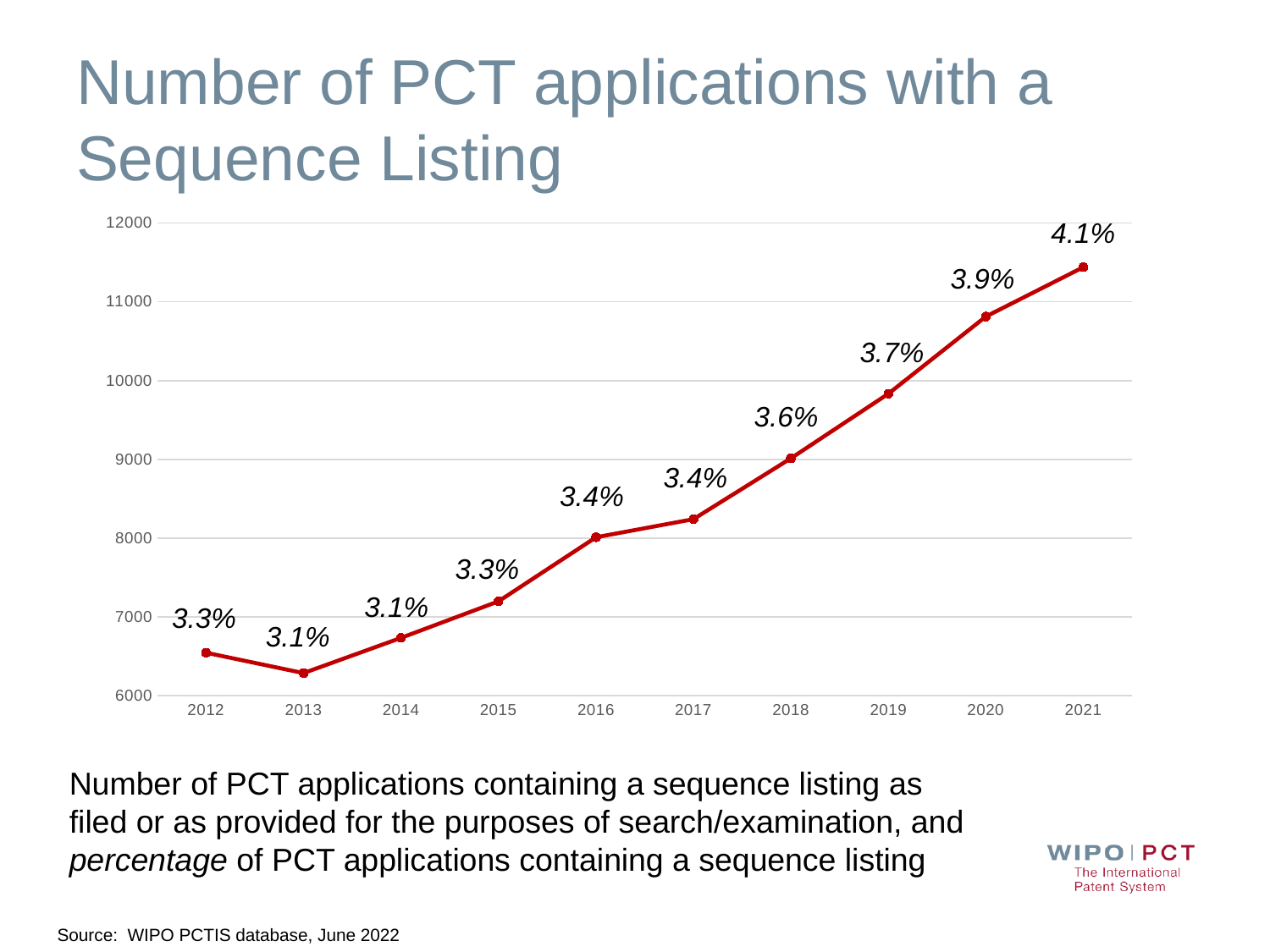
Is the value for 2012 greater or less than 7000? less What percentage label is shown for 2018? 3.6% Which year has the lowest number of PCT applications with a sequence listing? 2013 Do the values generally rise or fall from 2013 to 2021? rise Is the value for 2017 greater or less than 9000? less What kind of chart is shown on the slide? line chart How many years are plotted on the x axis? 10 Which year has the highest number of PCT applications with a sequence listing? 2021 What percentage label is shown for 2021? 4.1% Is the value for 2020 greater or less than 10000? greater What percentage label is shown for 2013? 3.1% Which year has the larger value, 2016 or 2019? 2019